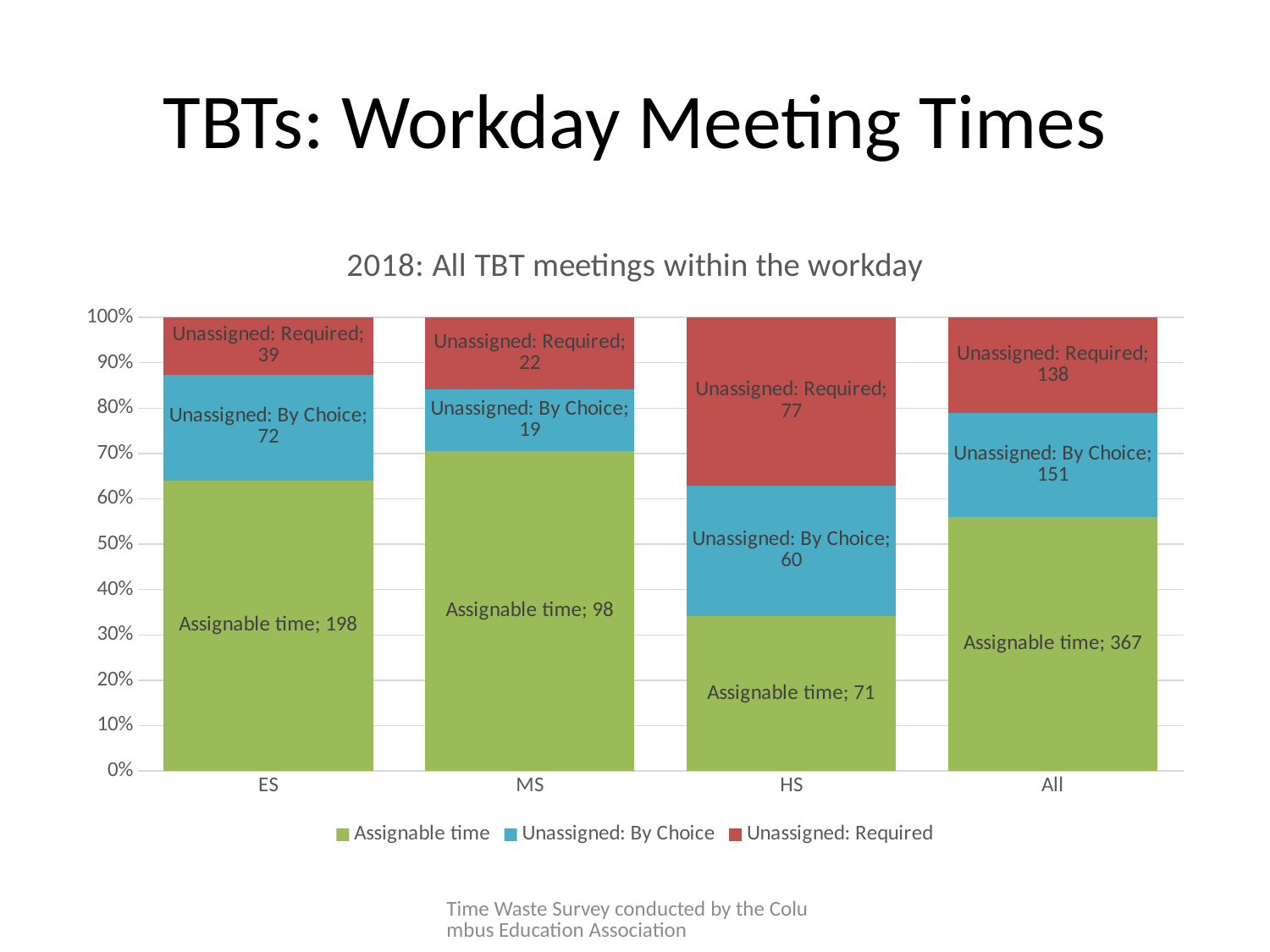
Which category has the lowest Unassigned: By Choice value? MS What is the total of the three values in the MS bar? 139 Which is larger in the HS category: Unassigned: By Choice or Unassigned: Required? Unassigned: Required Which category has the highest Assignable time value? All What is the value for Unassigned: By Choice in the All category? 151 What is the value for Assignable time in the ES category? 198 What kind of chart is shown? Stacked bar chart What is the value for Unassigned: Required in the HS category? 77 What is the difference between Assignable time for ES and Assignable time for MS? 100 Is the Assignable time share of the HS bar greater or less than 40%? less How many series does the legend list? 3 How many categories are shown on the x axis? 4